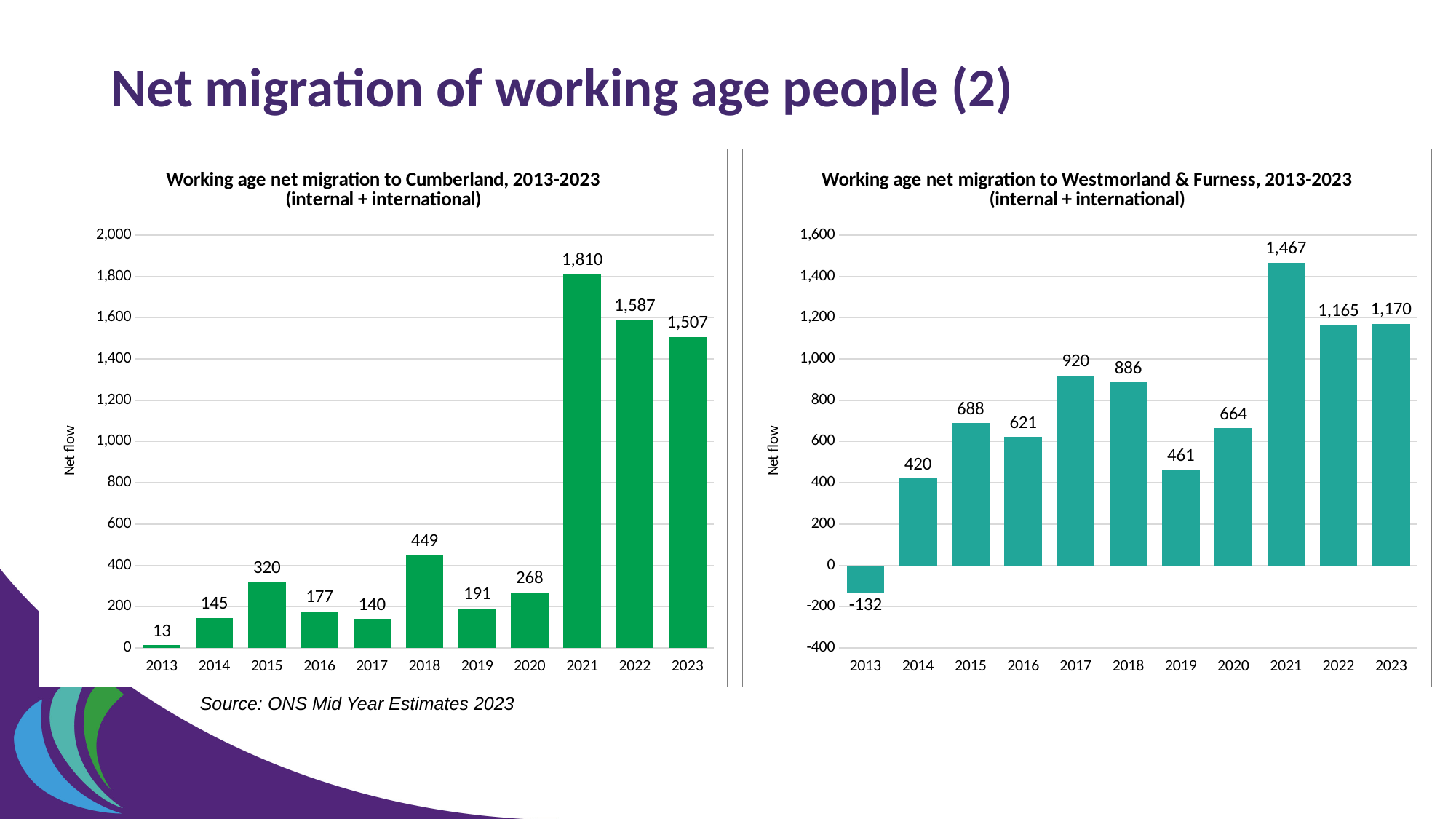
In the Cumberland chart, do the values rise or fall from 2021 to 2023? fall In the Westmorland & Furness chart, is the value for 2019 greater or less than 600? less In the Cumberland chart, what is the difference between the 2022 and 2023 values? 80 What kind of chart is the Westmorland & Furness chart? bar chart In the Westmorland & Furness chart, what is the net flow for 2013? -132 What is the y-axis label on the Cumberland chart? Net flow In the Cumberland chart, what is the net flow for 2021? 1,810 In the Cumberland chart, which is larger, the value for 2018 or the value for 2015? 2018 In the Cumberland chart, which year has the lowest net flow? 2013 In the Westmorland & Furness chart, what is the difference between the 2017 and 2018 values? 34 How many years are shown on the x axis of the Cumberland chart? 11 In the Westmorland & Furness chart, which year has the highest net flow? 2021